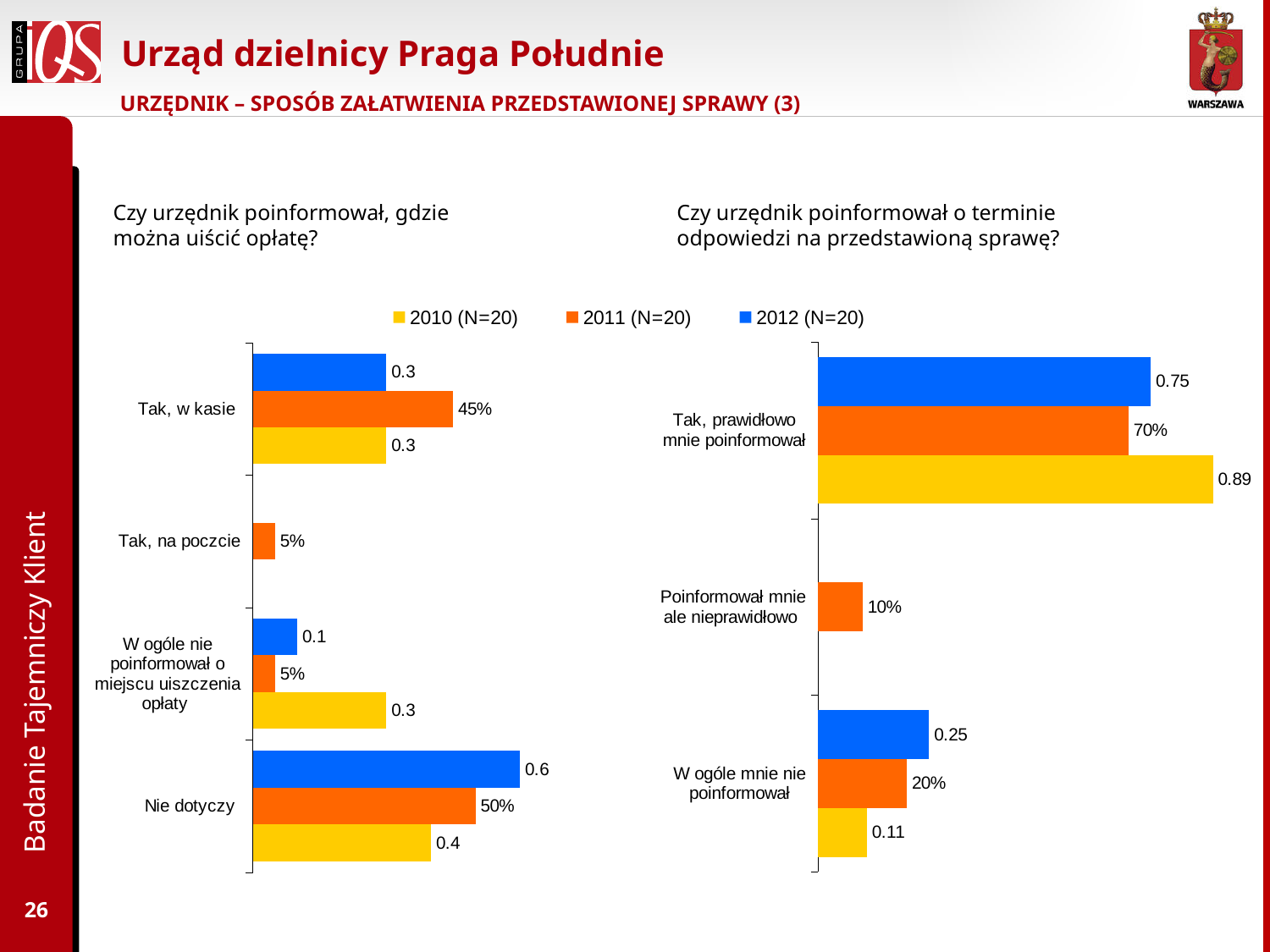
In the right chart (Czy urzędnik poinformował o terminie odpowiedzi na przedstawioną sprawę?), which category has the lowest value in the 2010 (N=20) series? W ogóle mnie nie poinformował What kind of chart is the right chart (Czy urzędnik poinformował o terminie odpowiedzi na przedstawioną sprawę?)? Bar chart In the right chart (Czy urzędnik poinformował o terminie odpowiedzi na przedstawioną sprawę?), which is larger for 'W ogóle mnie nie poinformował': the 2012 (N=20) value or the 2010 (N=20) value? 2012 (N=20) In the left chart (Czy urzędnik poinformował, gdzie można uiścić opłatę?), what is the value for 'Nie dotyczy' in the 2012 (N=20) series? 0.6 In the left chart (Czy urzędnik poinformował, gdzie można uiścić opłatę?), what is the value for 'Tak, w kasie' in the 2011 (N=20) series? 45% In the right chart (Czy urzędnik poinformował o terminie odpowiedzi na przedstawioną sprawę?), what is the value for 'Tak, prawidłowo mnie poinformował' in the 2010 (N=20) series? 0.89 In the right chart (Czy urzędnik poinformował o terminie odpowiedzi na przedstawioną sprawę?), what is the value for 'W ogóle mnie nie poinformował' in the 2011 (N=20) series? 20% How many series does the legend list? 3 In the left chart (Czy urzędnik poinformował, gdzie można uiścić opłatę?), what is the difference between the 2011 (N=20) values for 'Nie dotyczy' and 'Tak, w kasie'? 5 percentage points In the left chart (Czy urzędnik poinformował, gdzie można uiścić opłatę?), which category has the highest value in the 2012 (N=20) series? Nie dotyczy In the right chart (Czy urzędnik poinformował o terminie odpowiedzi na przedstawioną sprawę?), what is the difference between the 2011 (N=20) values for 'Tak, prawidłowo mnie poinformował' and 'W ogóle mnie nie poinformował'? 50 percentage points How many categories does the left chart (Czy urzędnik poinformował, gdzie można uiścić opłatę?) show? 4